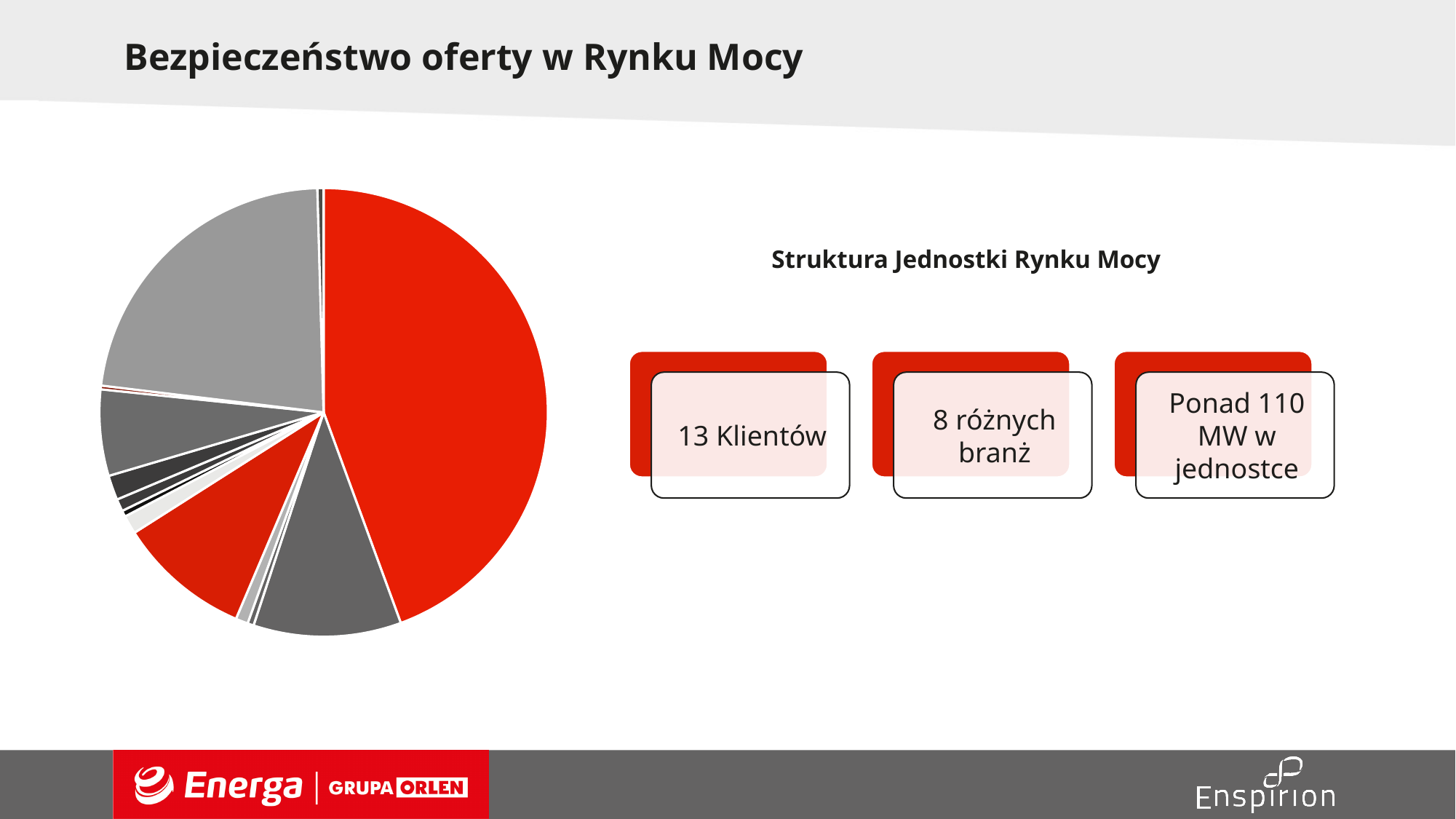
What colour is the largest slice of the pie chart? red What kind of chart is shown on the slide? pie chart Does the pie chart have a legend? No What is the title shown next to the pie chart? Struktura Jednostki Rynku Mocy